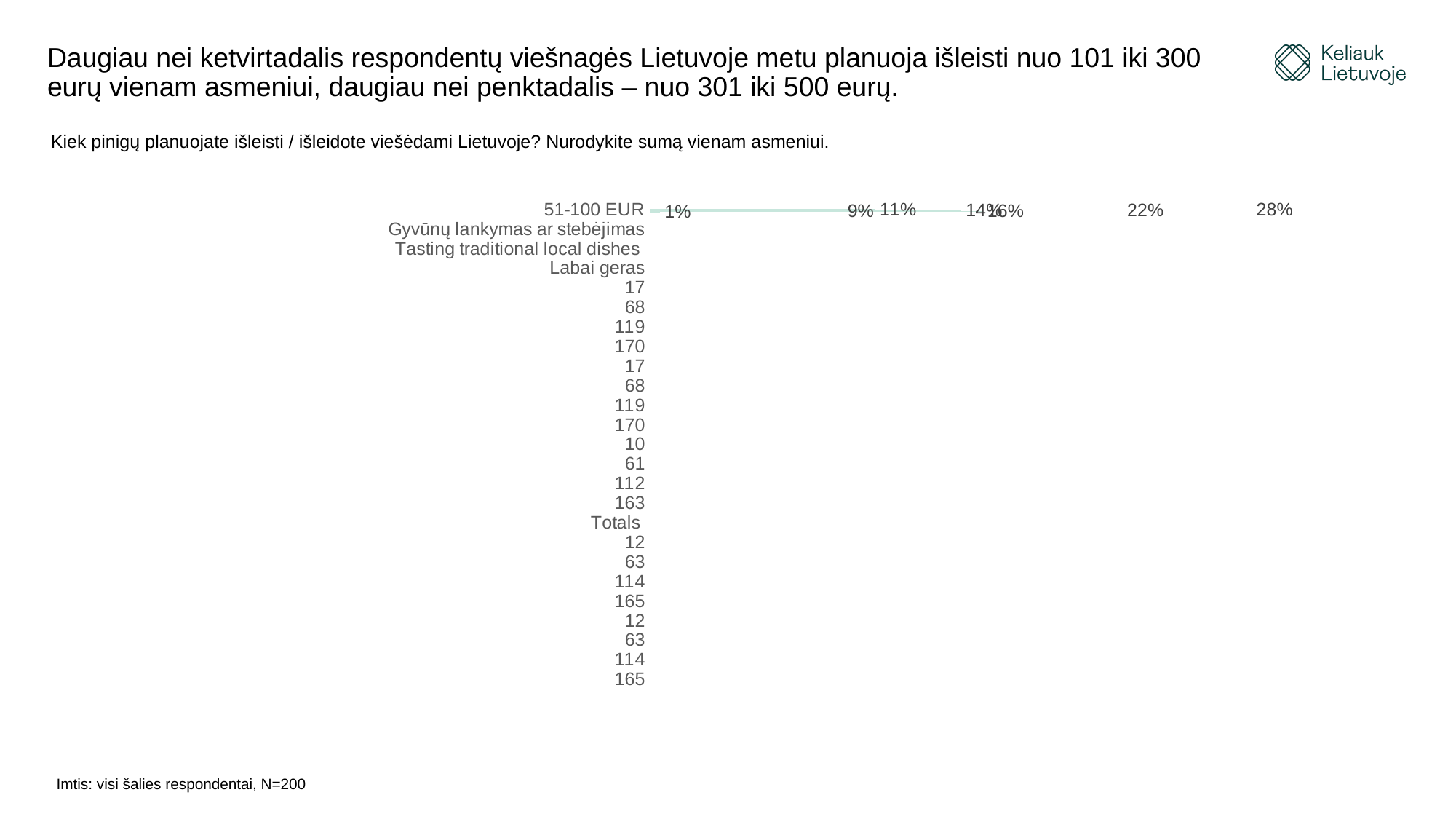
Which category label appears at the top of the chart's vertical axis, next to the plotted bar? 51-100 EUR What is the largest percentage data label shown on the chart? 28% What is the difference between the largest data label (28%) and the smallest data label (1%) on the chart? 27 percentage points Which is larger among the chart's data labels, 22% or 16%? 22% What sample size is stated at the bottom of the slide? N=200 What is the smallest percentage data label shown on the chart? 1%